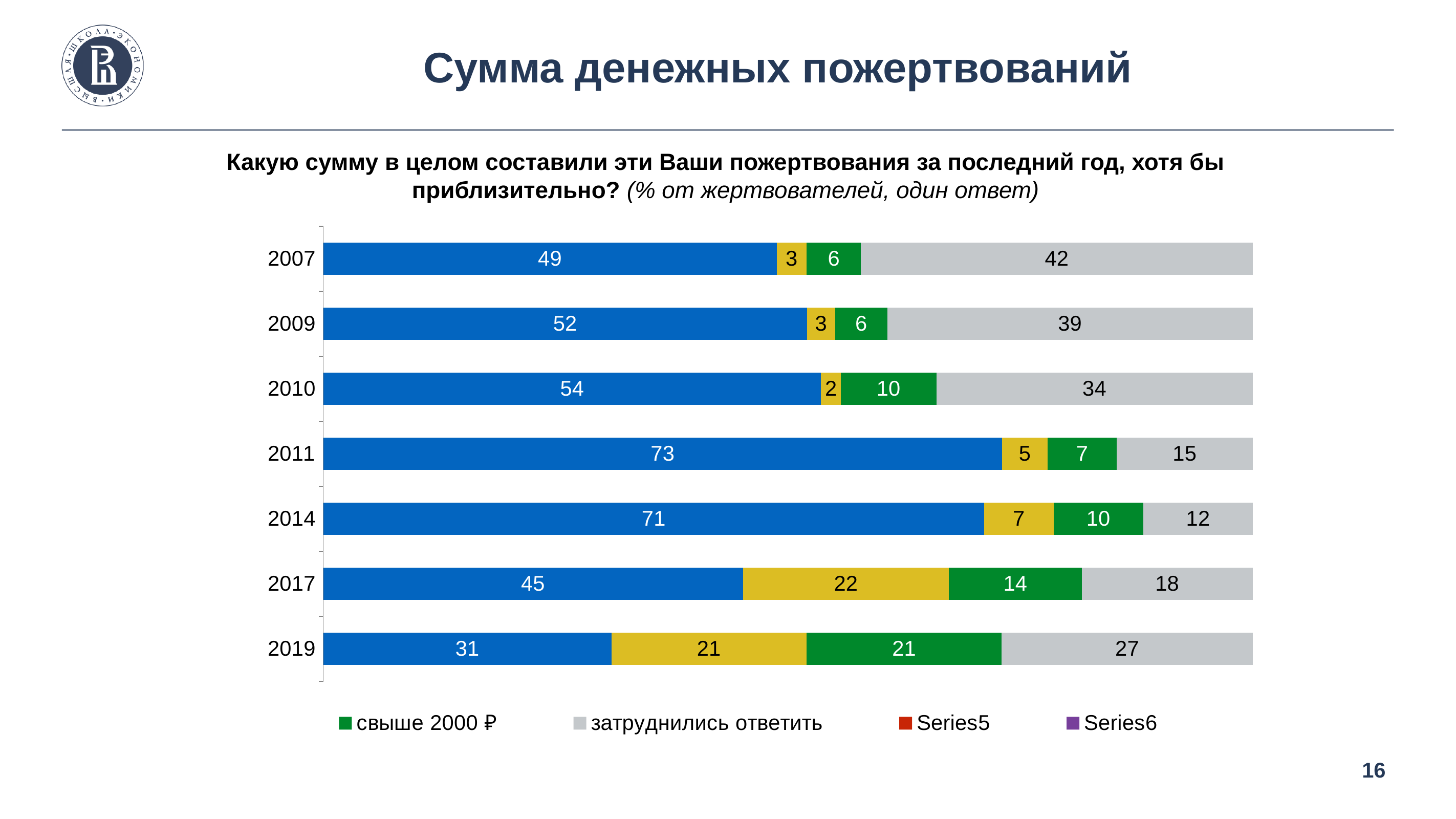
Which year has the highest value for 'затруднились ответить'? 2007 What is the value of the 'затруднились ответить' series for 2007? 42 What is the value of the blue segment for 2011? 73 What is the value of the 'свыше 2000 ₽' series for 2019? 21 Does the 'затруднились ответить' value rise or fall from 2007 to 2014? Fall What kind of chart is shown on the slide? Stacked bar chart What is the total of the stacked bar for 2019? 100 How many years are shown on the chart? 7 Which year has the lowest value for 'затруднились ответить'? 2014 What is the difference between the 'затруднились ответить' values for 2007 and 2019? 15 Which year has the larger 'свыше 2000 ₽' value, 2014 or 2017? 2017 Which year has the highest value for 'свыше 2000 ₽'? 2019